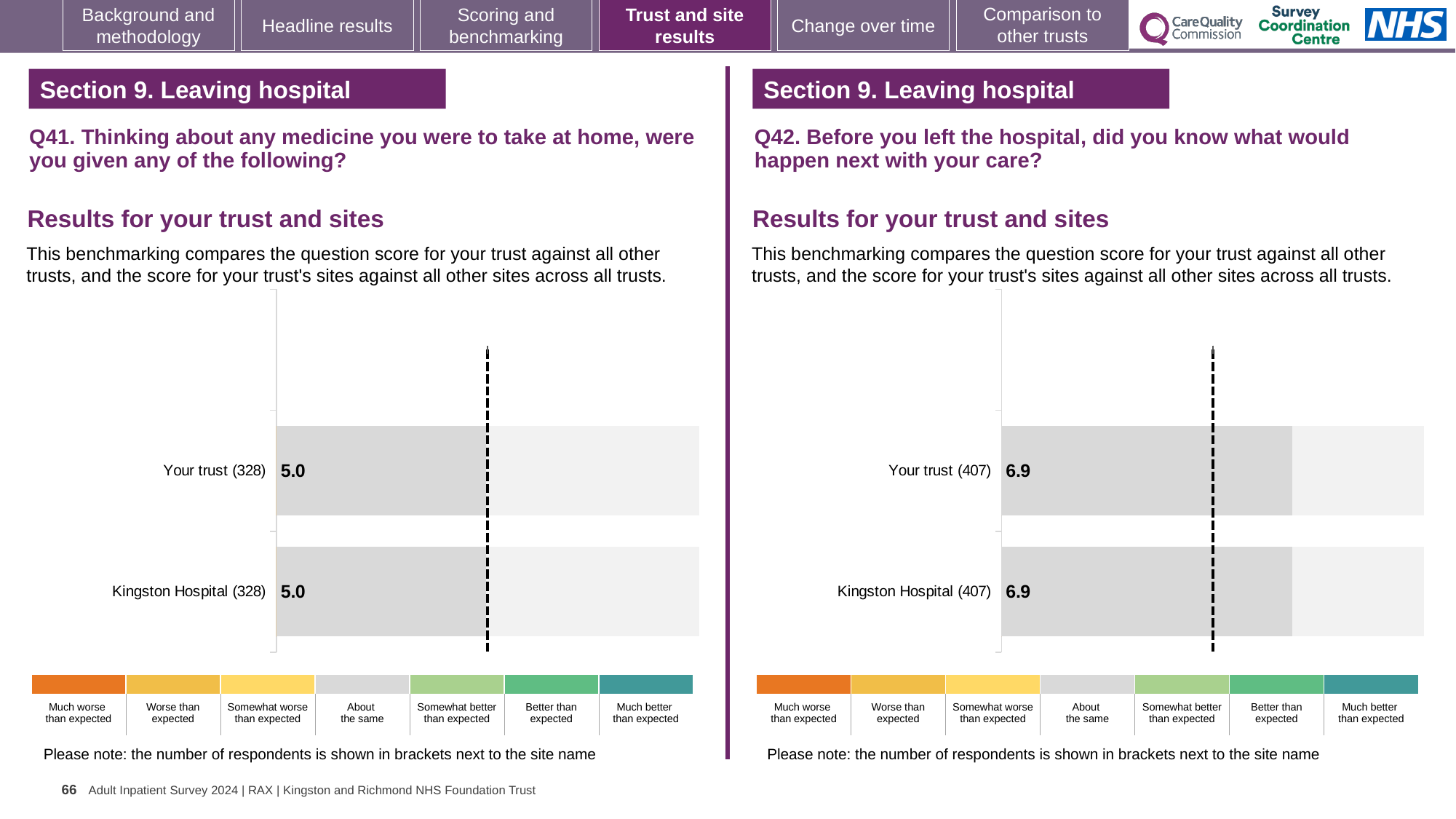
On the Q41 chart, what is the score for Your trust? 5.0 On the Q42 chart, which benchmark category does the colour of the Your trust bar correspond to? About the same On the Q41 chart, what is the difference between the score for Your trust and the score for Kingston Hospital? 0.0 On the Q41 chart, what is the score for Kingston Hospital? 5.0 On the Q42 chart, what is the score for Your trust? 6.9 What kind of chart is the Q41 chart? Bar chart Is the score for Your trust on the Q42 chart greater or less than the score for Your trust on the Q41 chart? greater On the Q42 chart, how many bars are plotted? 2 On the Q42 chart, what is the score for Kingston Hospital? 6.9 How many benchmark categories are listed in the colour key below the Q41 chart? 7 On the Q42 chart, how many respondents are shown in brackets next to Your trust? 407 On the Q41 chart, how many respondents are shown in brackets next to Kingston Hospital? 328